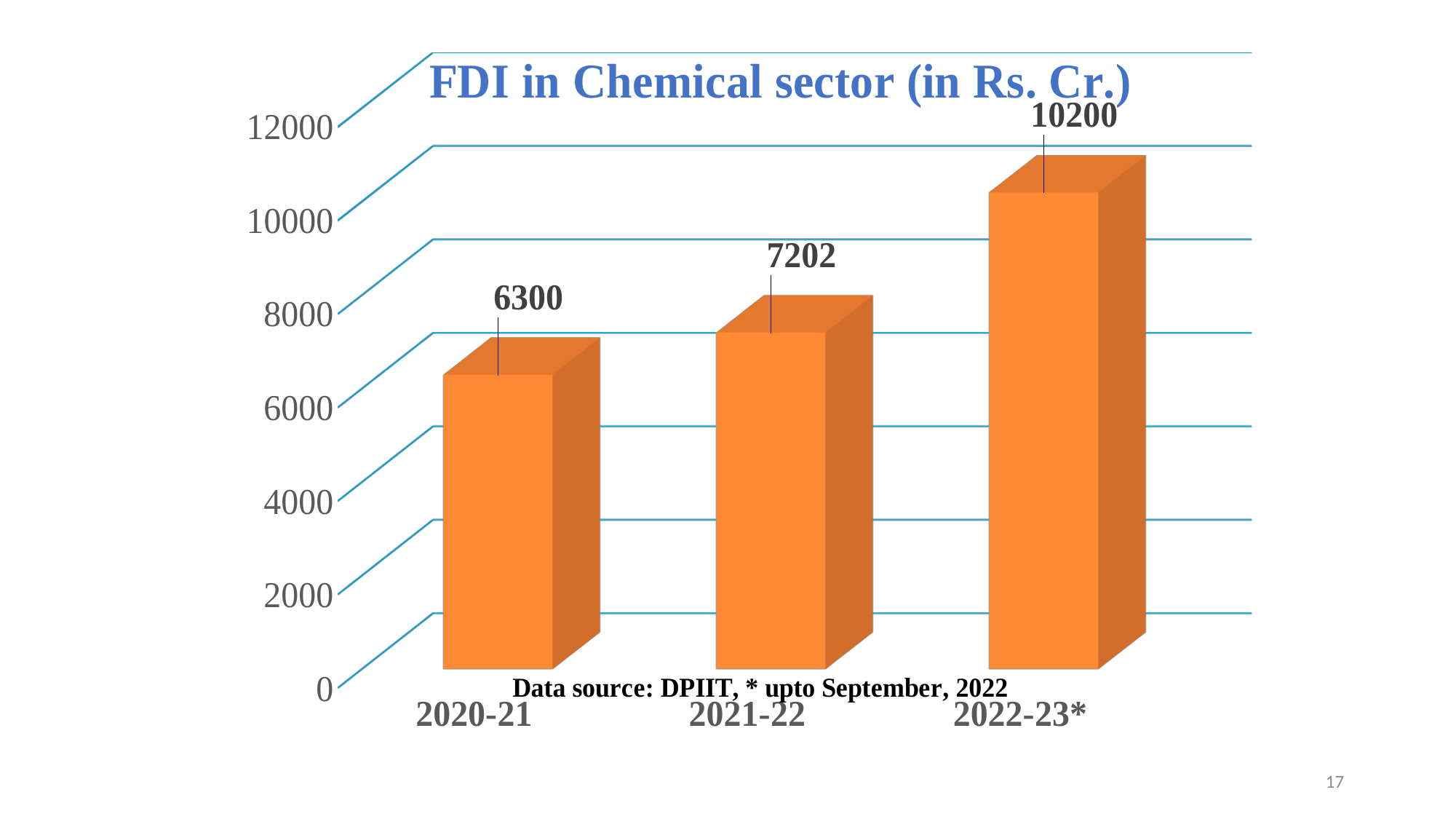
What is the FDI value for 2022-23*? 10200 How many years are shown on the chart? 3 What kind of chart is shown on the slide? bar chart Do the FDI values rise or fall from 2020-21 to 2022-23*? rise Which year has the highest FDI in the chemical sector? 2022-23* What is the FDI value for 2021-22? 7202 Is the value for 2022-23* greater or less than 8000? greater What is the FDI value for 2020-21? 6300 Which is larger, the FDI value for 2020-21 or for 2021-22? 2021-22 What is the difference between the FDI values for 2021-22 and 2020-21? 902 Which year has the lowest FDI in the chemical sector? 2020-21 What is the difference between the FDI values for 2022-23* and 2021-22? 2998